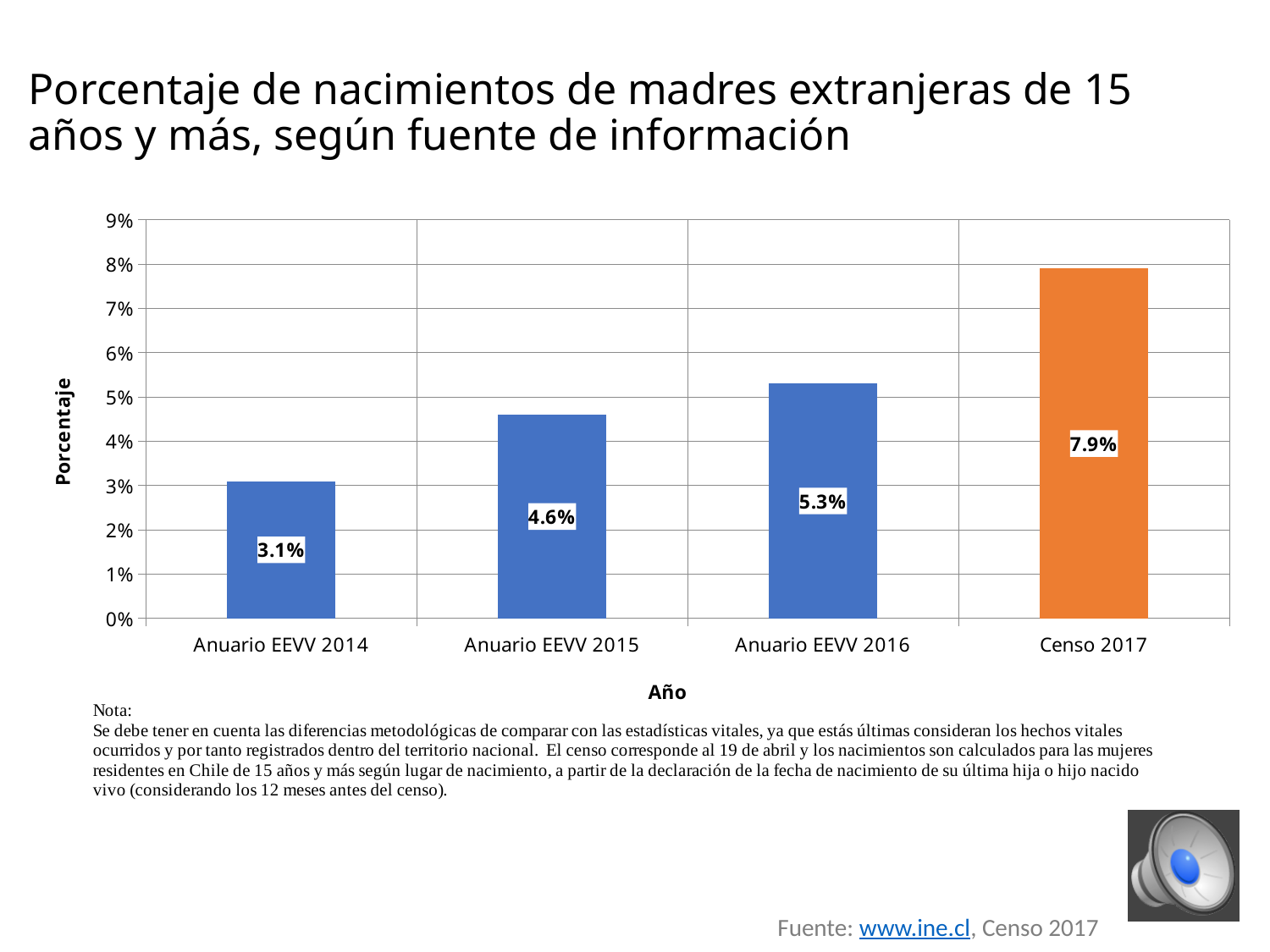
What is the value for Anuario EEVV 2016? 5.3% What is the value for Anuario EEVV 2014? 3.1% Which category has the lowest value? Anuario EEVV 2014 What is the value for Anuario EEVV 2015? 4.6% What is the difference between the values for Censo 2017 and Anuario EEVV 2016? 2.6% Do the values rise or fall from Anuario EEVV 2014 to Censo 2017? rise What kind of chart is shown on the slide? bar chart How many categories are shown on the x axis? 4 Is the value for Censo 2017 greater or less than 7%? greater Which category has the highest value? Censo 2017 Which is larger, the value for Anuario EEVV 2015 or Anuario EEVV 2016? Anuario EEVV 2016 What is the value for Censo 2017? 7.9%